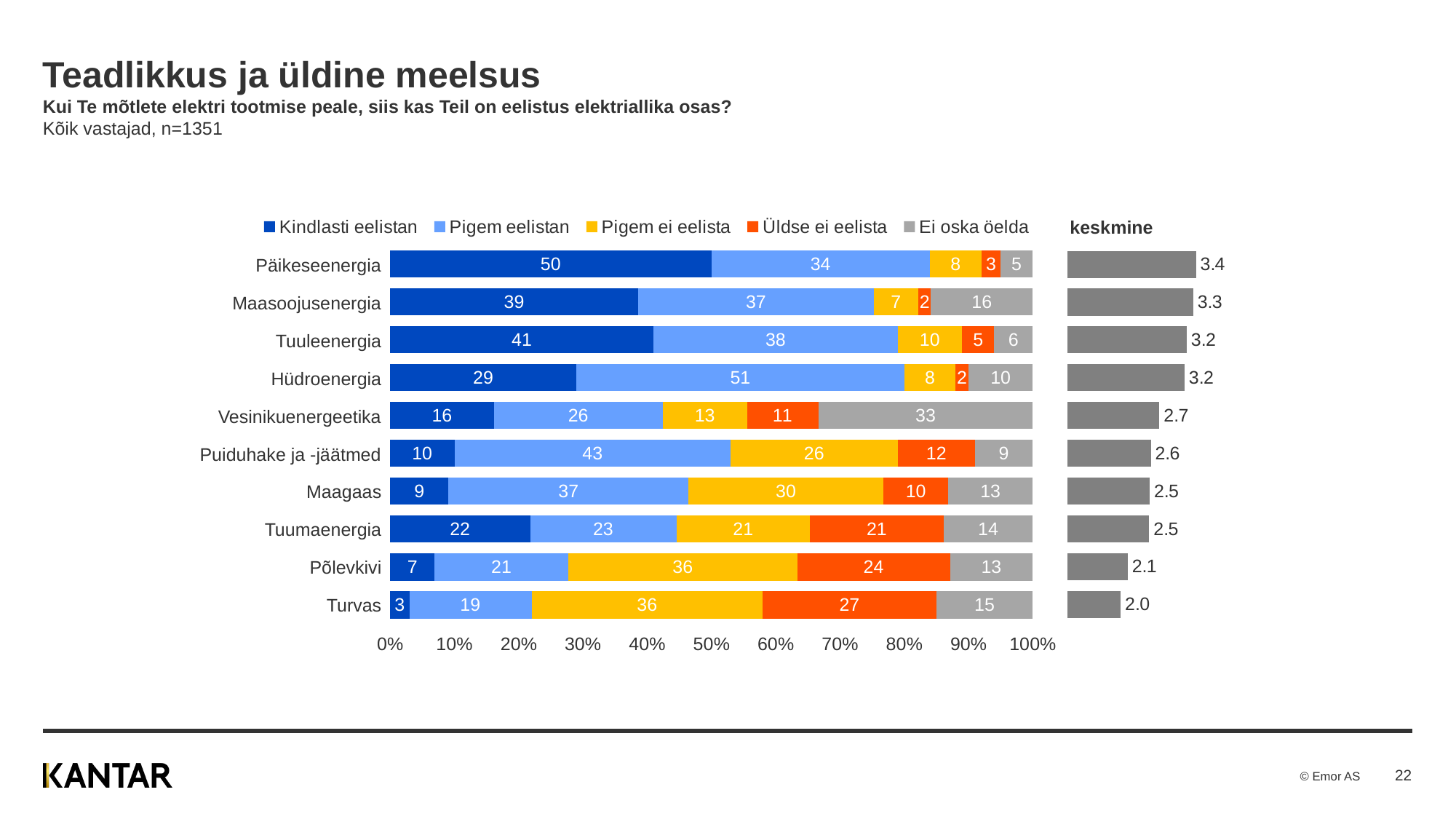
In the stacked bar chart, which category has the highest "Pigem eelistan" value? Hüdroenergia In the "keskmine" chart on the right, what is the value for Hüdroenergia? 3.2 In the stacked bar chart, what is the value of "Üldse ei eelista" for Turvas? 27 In the stacked bar chart, what is the difference between the "Kindlasti eelistan" values for Tuuleenergia and Maasoojusenergia? 2 How many series does the legend of the stacked bar chart list? 5 How many categories are shown in the stacked bar chart? 10 What type of chart is the main chart on the slide? Stacked bar chart In the "keskmine" chart on the right, which category has the highest value? Päikeseenergia In the stacked bar chart, what is the value of "Ei oska öelda" for Vesinikuenergeetika? 33 In the stacked bar chart, which is larger: the "Pigem ei eelista" value for Maagaas or for Puiduhake ja -jäätmed? Maagaas In the stacked bar chart, what is the value of "Kindlasti eelistan" for Päikeseenergia? 50 In the "keskmine" chart on the right, which category has the lowest value? Turvas